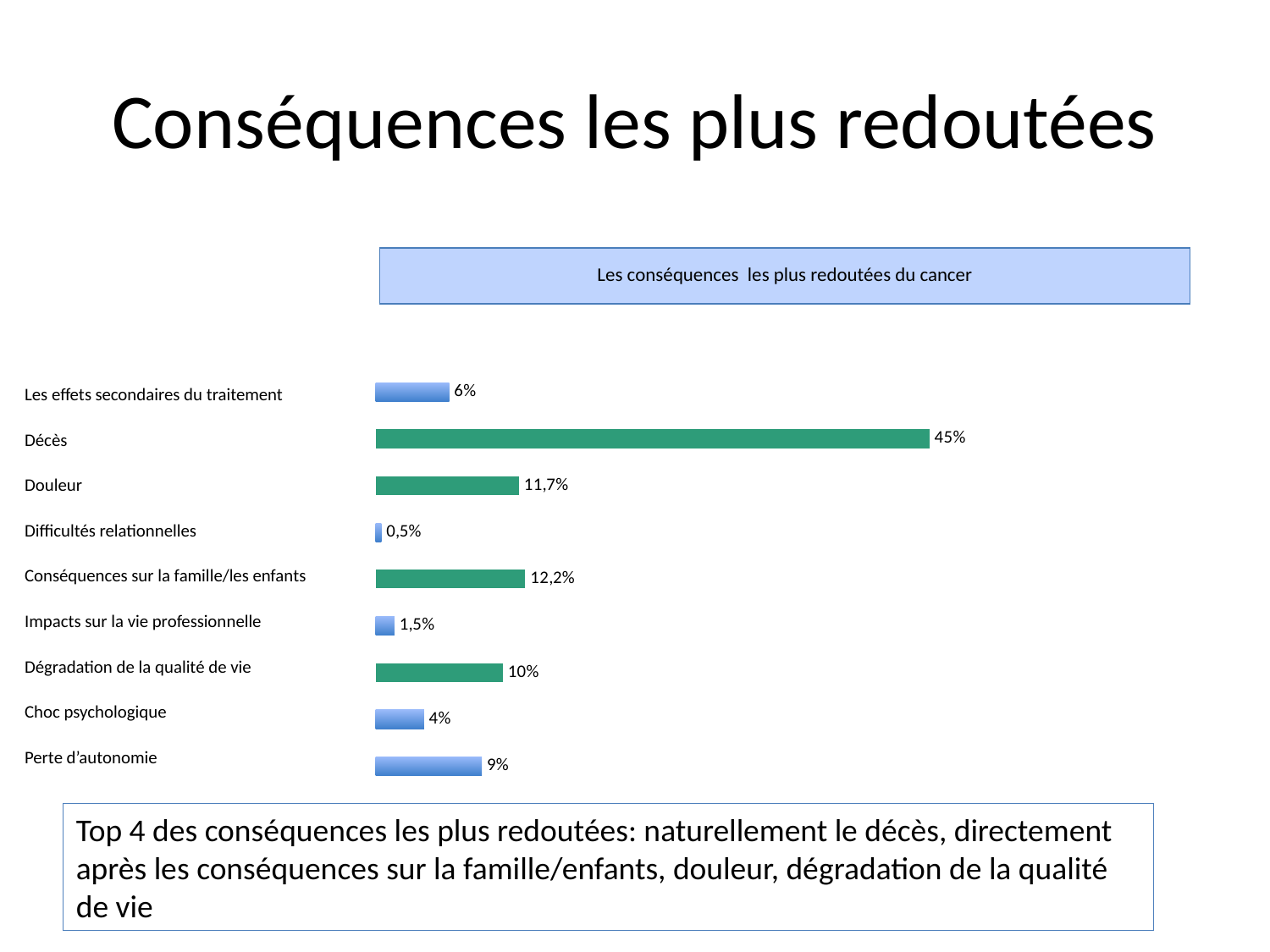
Which category has the lowest value? Difficultés relationnelles What is the value for Décès? 45% How many categories are shown in the chart? 9 Which is larger, the value for Conséquences sur la famille/les enfants or the value for Douleur? Conséquences sur la famille/les enfants Which category has the highest value? Décès What is the title of the chart? Les conséquences les plus redoutées du cancer What is the difference between the values for Dégradation de la qualité de vie and Choc psychologique? 6% What is the difference between the values for Décès and Douleur? 33,3% What is the value for Conséquences sur la famille/les enfants? 12,2% What is the value for Douleur? 11,7% What kind of chart is shown on the slide? Bar chart What is the value for Perte d'autonomie? 9%